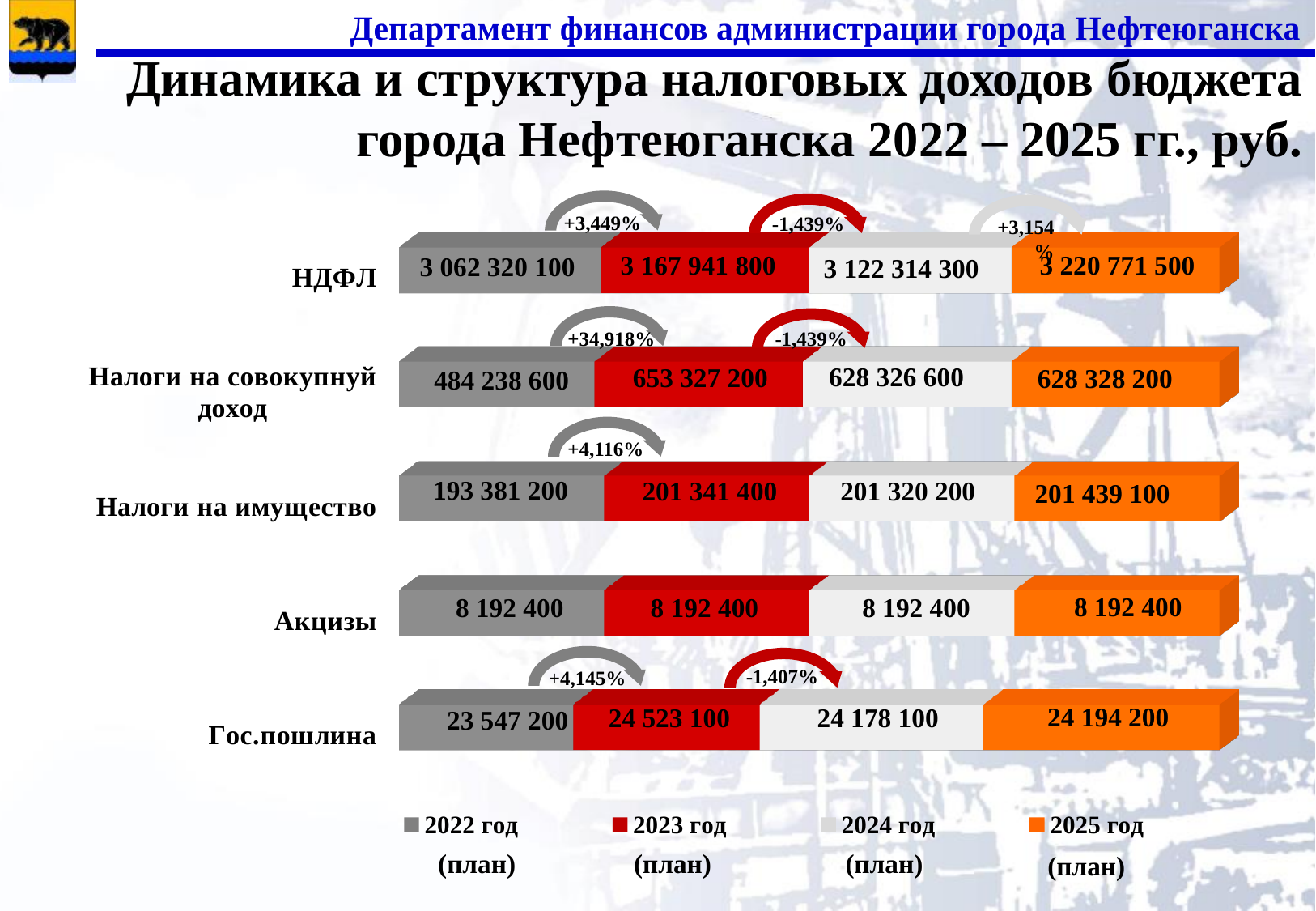
What is the value for НДФЛ in 2022 год (план)? 3 062 320 100 How many series does the legend list? 4 What is the value for Налоги на имущество in 2025 год (план)? 201 439 100 What is the value for Налоги на совокупный доход in 2023 год (план)? 653 327 200 Which category has the lowest value in 2023 год (план)? Акцизы What is the value for Гос.пошлина in 2024 год (план)? 24 178 100 Which year has the highest value for НДФЛ? 2025 год (план) What is the difference between the 2025 год (план) and 2024 год (план) values for НДФЛ? 98 457 200 What percentage change is shown between 2022 and 2023 for Налоги на совокупный доход? +34,918% How many tax categories are shown in the chart? 5 What is the value for Акцизы in 2022 год (план)? 8 192 400 Which is larger for Налоги на совокупный доход: the 2023 год (план) value or the 2024 год (план) value? 2023 год (план)